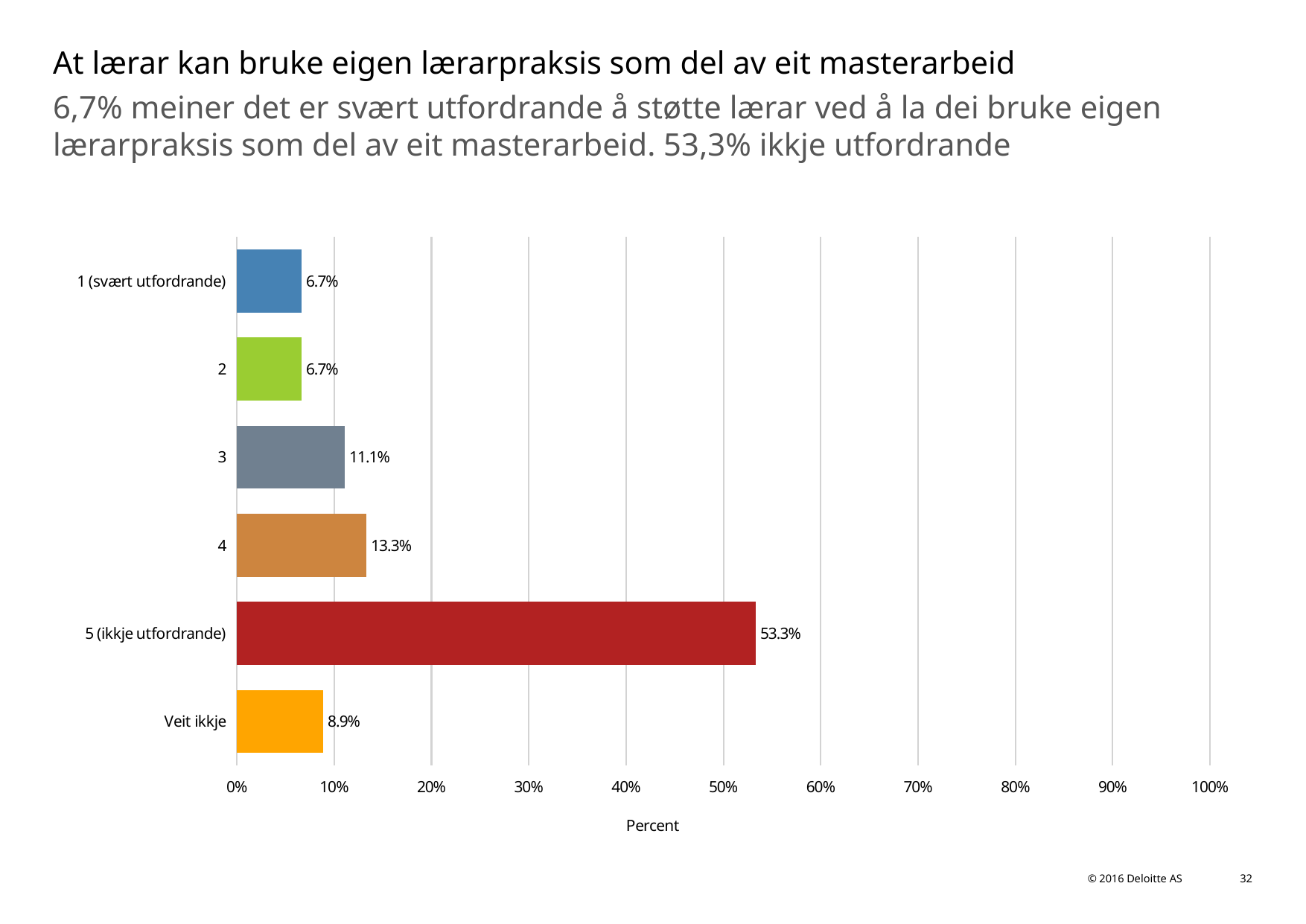
What is the label of the horizontal axis? Percent Which is larger, the value for category 3 or the value for "Veit ikkje"? 3 What is the value for "Veit ikkje"? 8.9% What is the value for category 3? 11.1% What kind of chart is shown on the slide? bar chart Is the value for "5 (ikkje utfordrande)" greater or less than 50%? greater How many categories are shown in the chart? 6 What is the value for category 4? 13.3% What is the value for "5 (ikkje utfordrande)"? 53.3% What is the difference between the values for category 4 and category 3? 2.2% Which category has the highest value? 5 (ikkje utfordrande) What is the difference between the values for "5 (ikkje utfordrande)" and category 4? 40.0%